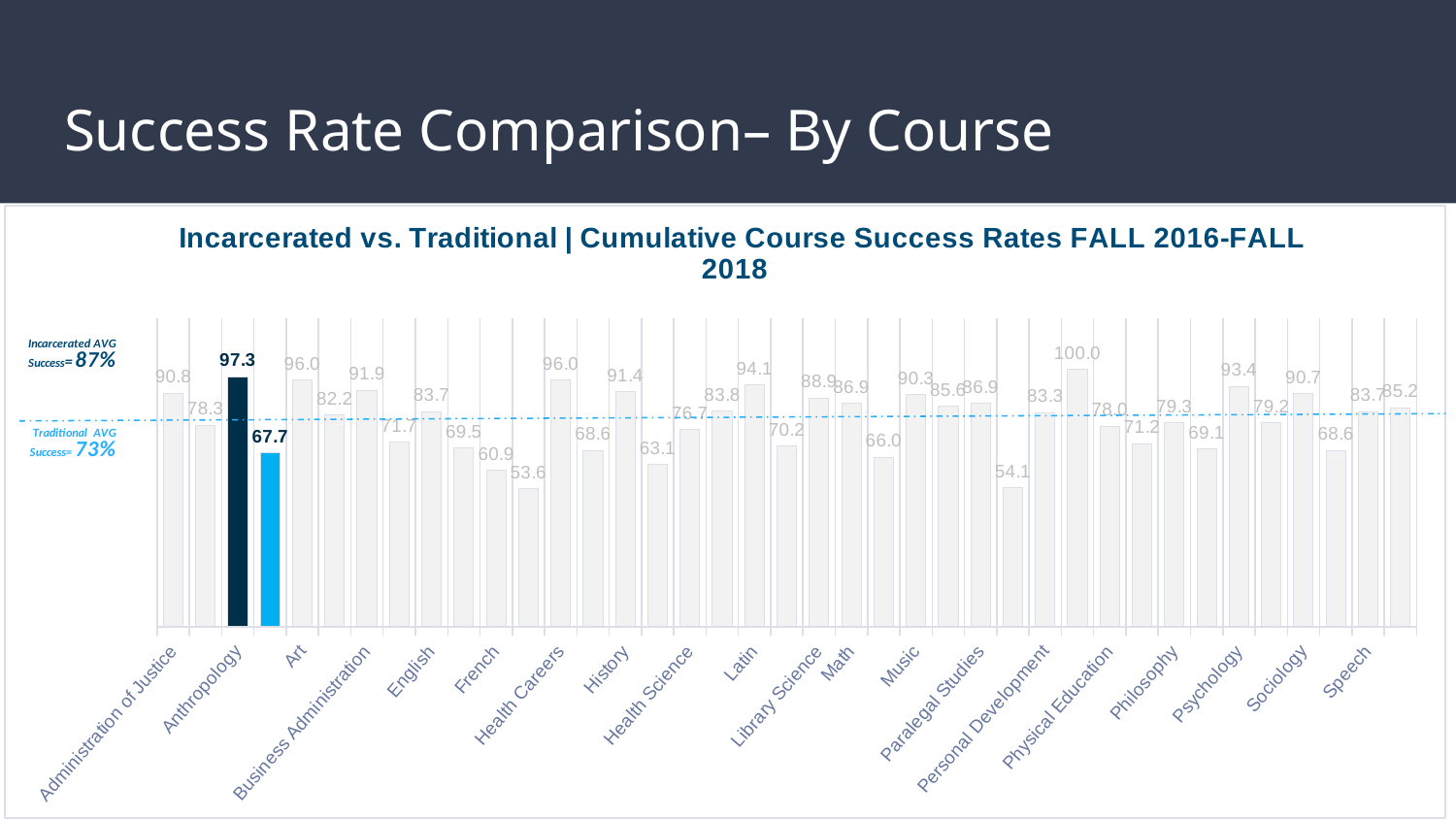
What type of chart is shown on the slide? bar chart What is the highest value labelled on any bar in the chart? 100.0 How many courses are listed along the x axis of the chart? 20 Which course is highlighted with coloured bars while all other courses are shown in grey? Anthropology Which of the two highlighted Anthropology bars is larger, the incarcerated (dark) bar or the traditional (light blue) bar? incarcerated (dark) bar What is the traditional success rate for Anthropology (the light blue highlighted bar)? 67.7 What is the title of the chart? Incarcerated vs. Traditional | Cumulative Course Success Rates FALL 2016-FALL 2018 What is the Traditional AVG Success rate shown on the chart? 73% What is the difference between the two highlighted Anthropology bars (97.3 and 67.7)? 29.6 What is the Incarcerated AVG Success rate shown on the chart? 87% What is the lowest value labelled on any bar in the chart? 53.6 What is the incarcerated success rate for Anthropology (the dark highlighted bar)? 97.3